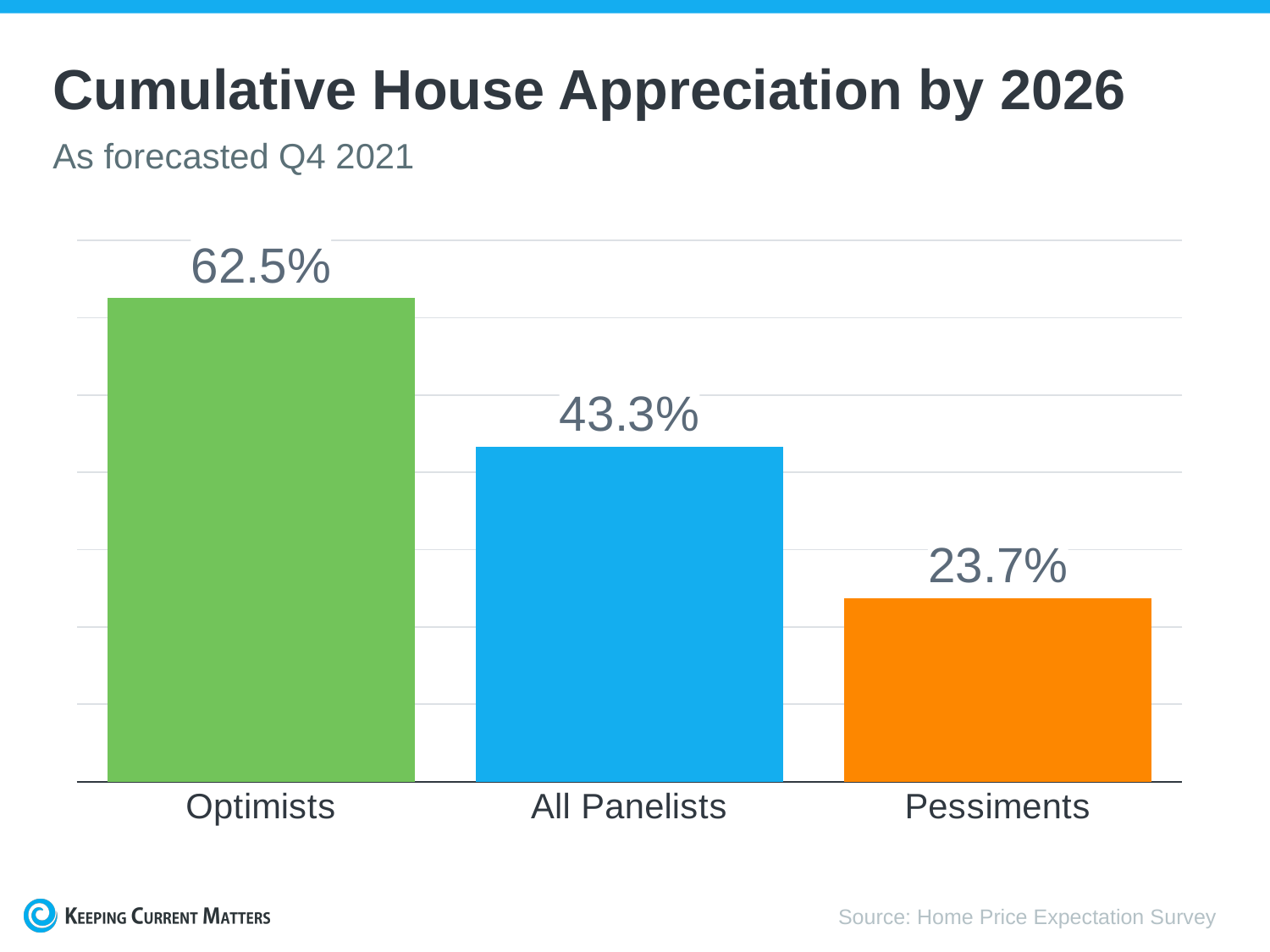
What is the difference between the Optimists and Pessiments forecasts? 38.8% What is the cumulative house appreciation by 2026 forecast for Optimists? 62.5% What is the cumulative house appreciation by 2026 forecast for Pessiments? 23.7% Do the values rise or fall from left to right across the categories? Fall What is the cumulative house appreciation by 2026 forecast for All Panelists? 43.3% What is the difference between the Optimists and All Panelists forecasts? 19.2% What is the title of the chart? Cumulative House Appreciation by 2026 What kind of chart is shown on the slide? Bar chart Which is larger, the forecast for All Panelists or for Pessiments? All Panelists How many categories are shown in the chart? 3 Which category has the highest forecast cumulative house appreciation? Optimists Which category has the lowest forecast cumulative house appreciation? Pessiments